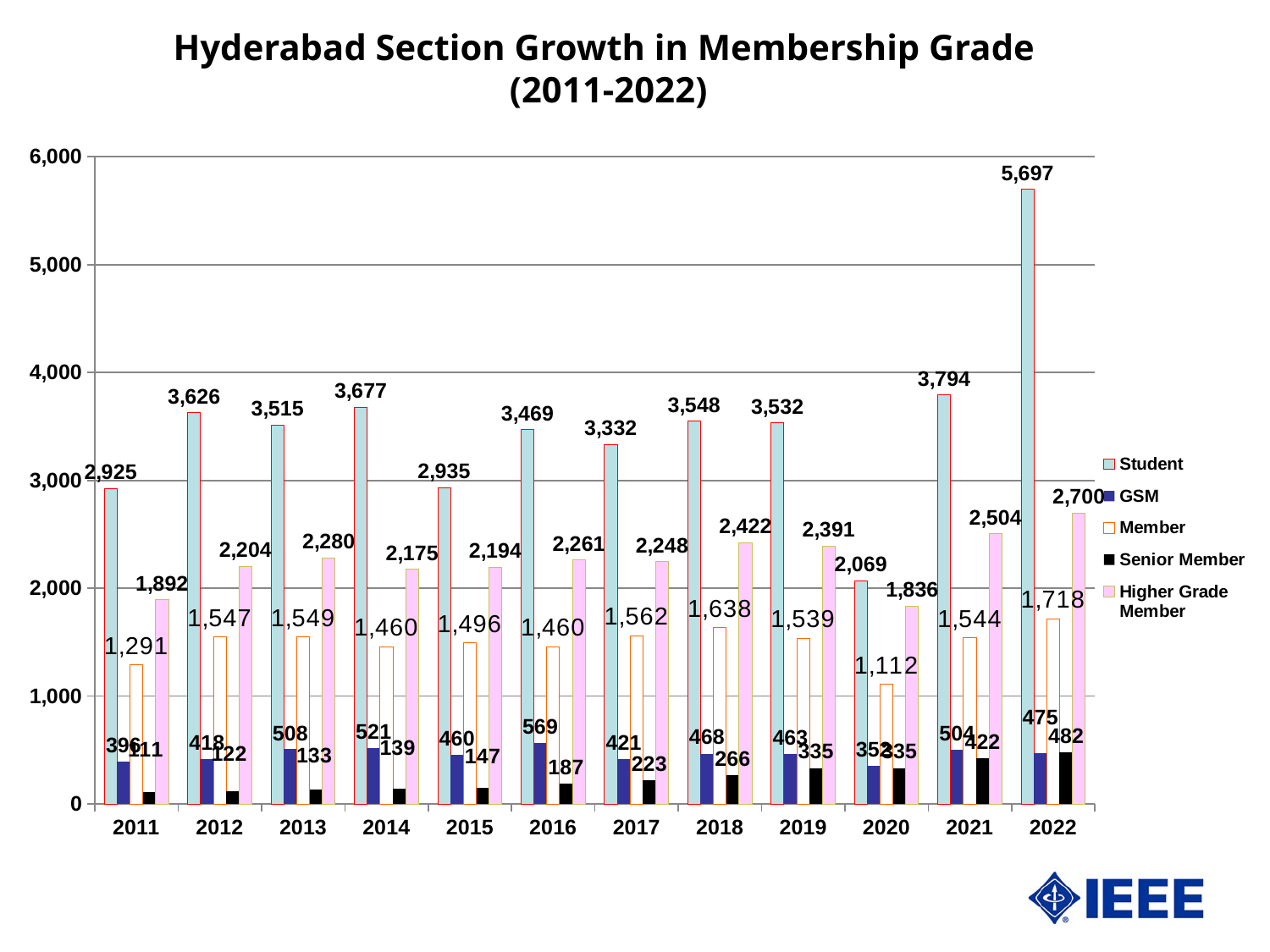
How many years are shown on the x axis? 12 Is the Senior Member value for 2022 greater or less than 1,000? less In which year is the Student value highest? 2022 What is the Student value for 2022? 5,697 What is the Higher Grade Member value for 2022? 2,700 How many series does the legend list? 5 What is the Member value for 2011? 1,291 What is the difference between the Student values for 2022 and 2021? 1,903 Which year has the larger Member value, 2018 or 2019? 2018 Do the Senior Member values rise or fall from 2011 to 2019? rise In which year is the Student value lowest? 2020 What kind of chart is this? bar chart